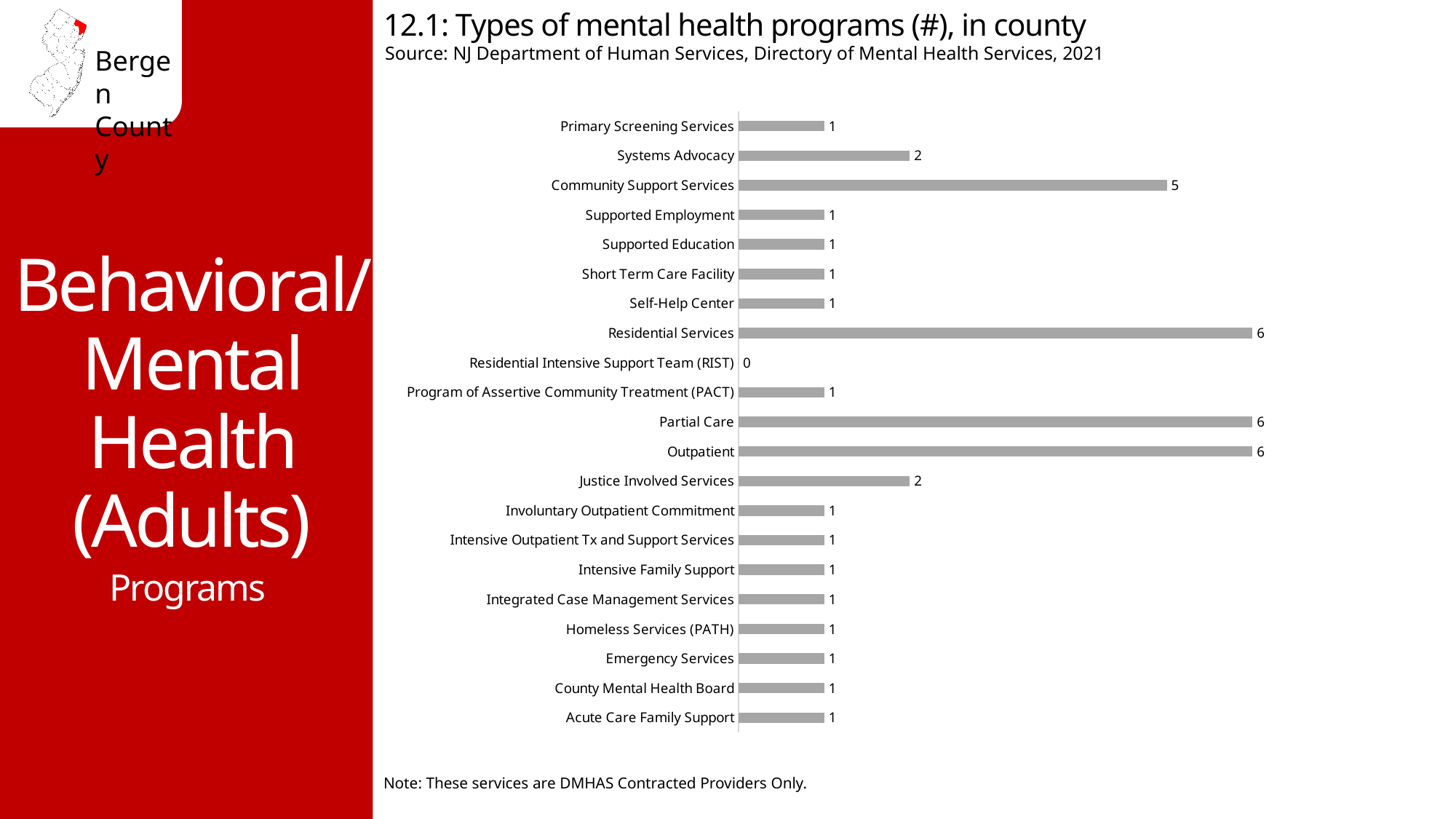
What kind of chart is shown on the slide? Bar chart What is the difference between the values for Outpatient and Justice Involved Services? 4 What is the value for Partial Care? 6 How many categories are shown in the chart? 21 Which category has the lowest value? Residential Intensive Support Team (RIST) What is the difference between the values for Community Support Services and Primary Screening Services? 4 What is the value for Systems Advocacy? 2 Which is larger, the value for Systems Advocacy or the value for Self-Help Center? Systems Advocacy What is the value for Community Support Services? 5 What is the title of the chart? 12.1: Types of mental health programs (#), in county Which is larger, the value for Community Support Services or the value for Residential Services? Residential Services What is the value for Residential Intensive Support Team (RIST)? 0